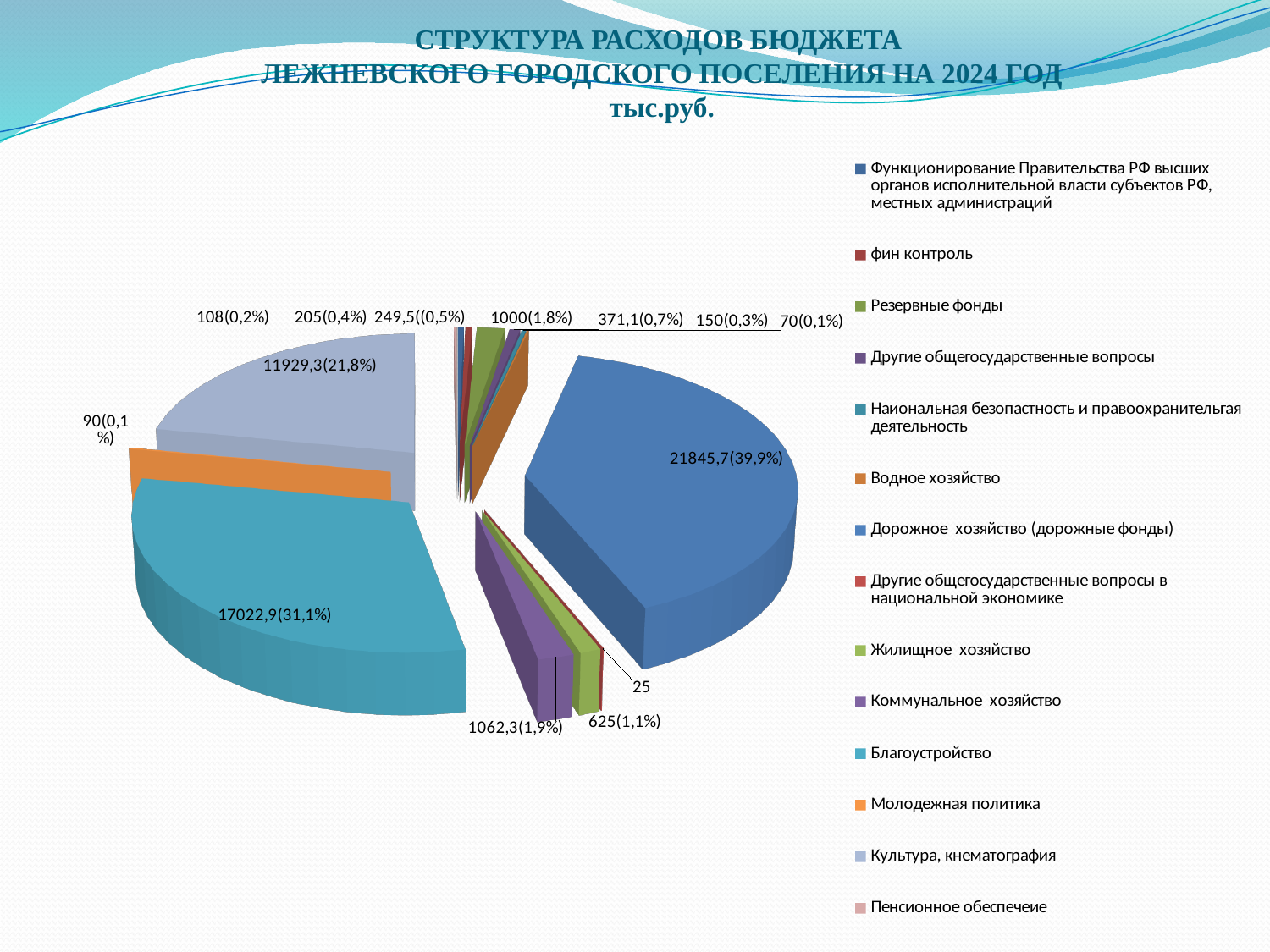
What percentage share is shown for the slice labeled 1000? 1,8% How many entries does the legend of the pie chart list? 14 What is the data label of the largest slice of the pie chart? 21845,7(39,9%) What percentage share is shown for the slice labeled 1062,3? 1,9% What percentage share does the largest slice of the pie chart have? 39,9% Which slice value is larger: 11929,3 or 17022,9? 17022,9 What is the difference between the two largest slice values, 21845,7 and 17022,9? 4822,8 In what units are the values of the chart given, according to the title? тыс.руб. What kind of chart is shown on the slide? pie chart For which year does the chart show the budget expenditure structure? 2024